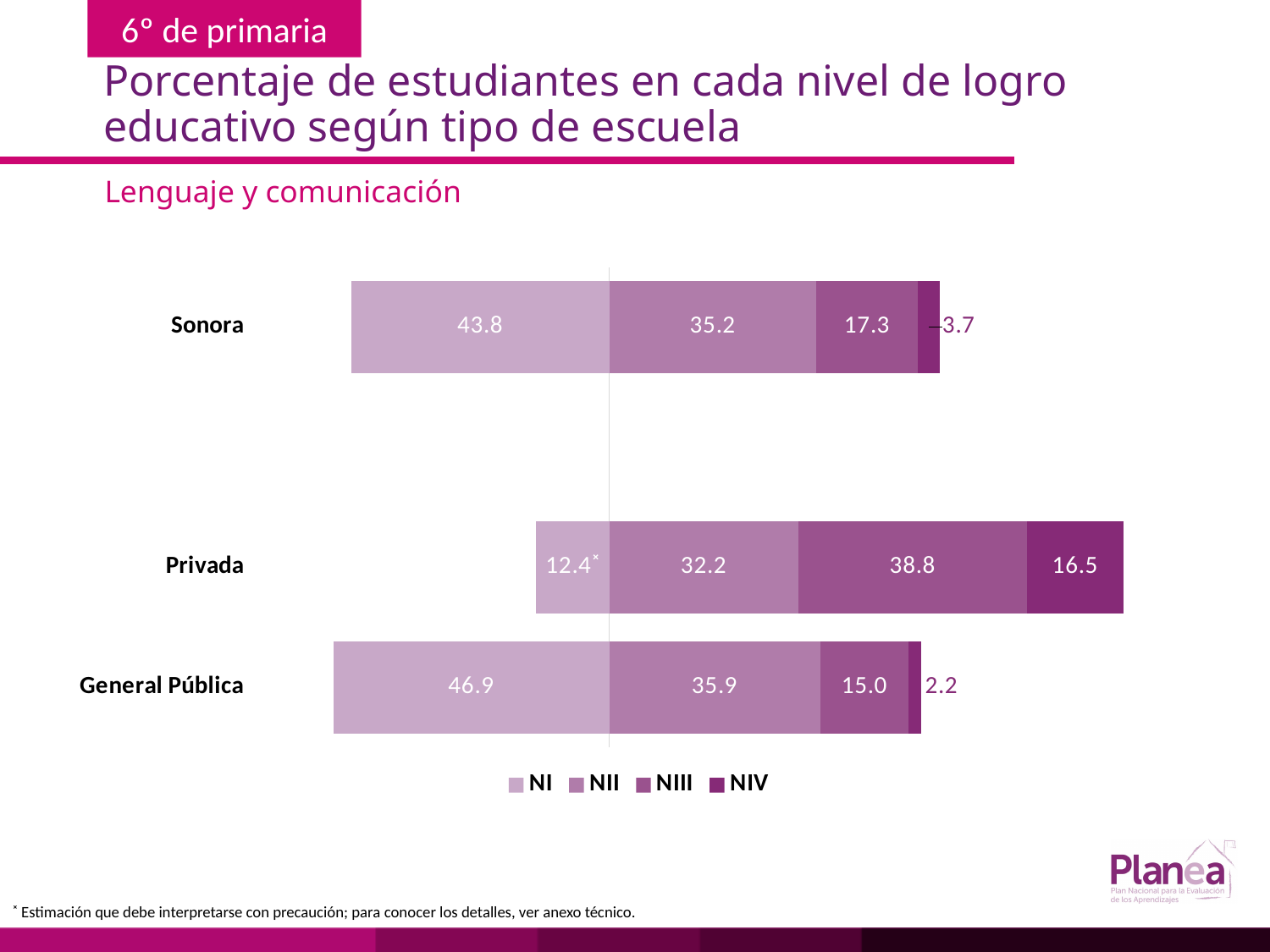
Which school type has the lowest NI value? Privada How many school types (categories) are shown in the chart? 3 What kind of chart is shown on the slide? Stacked bar chart What percentage of Sonora students are at level NI? 43.8 Which is larger, the NIII value for Privada or the NIII value for Sonora? Privada What is the difference between the NI values for General Pública and Sonora? 3.1 What is the NI value shown for Privada? 12.4 Which school type has the highest NIV value? Privada What is the NIII value for General Pública? 15.0 What is the total of the stacked bar for Sonora? 100.0 How many series does the legend list? 4 What is the NIV value for Privada schools? 16.5